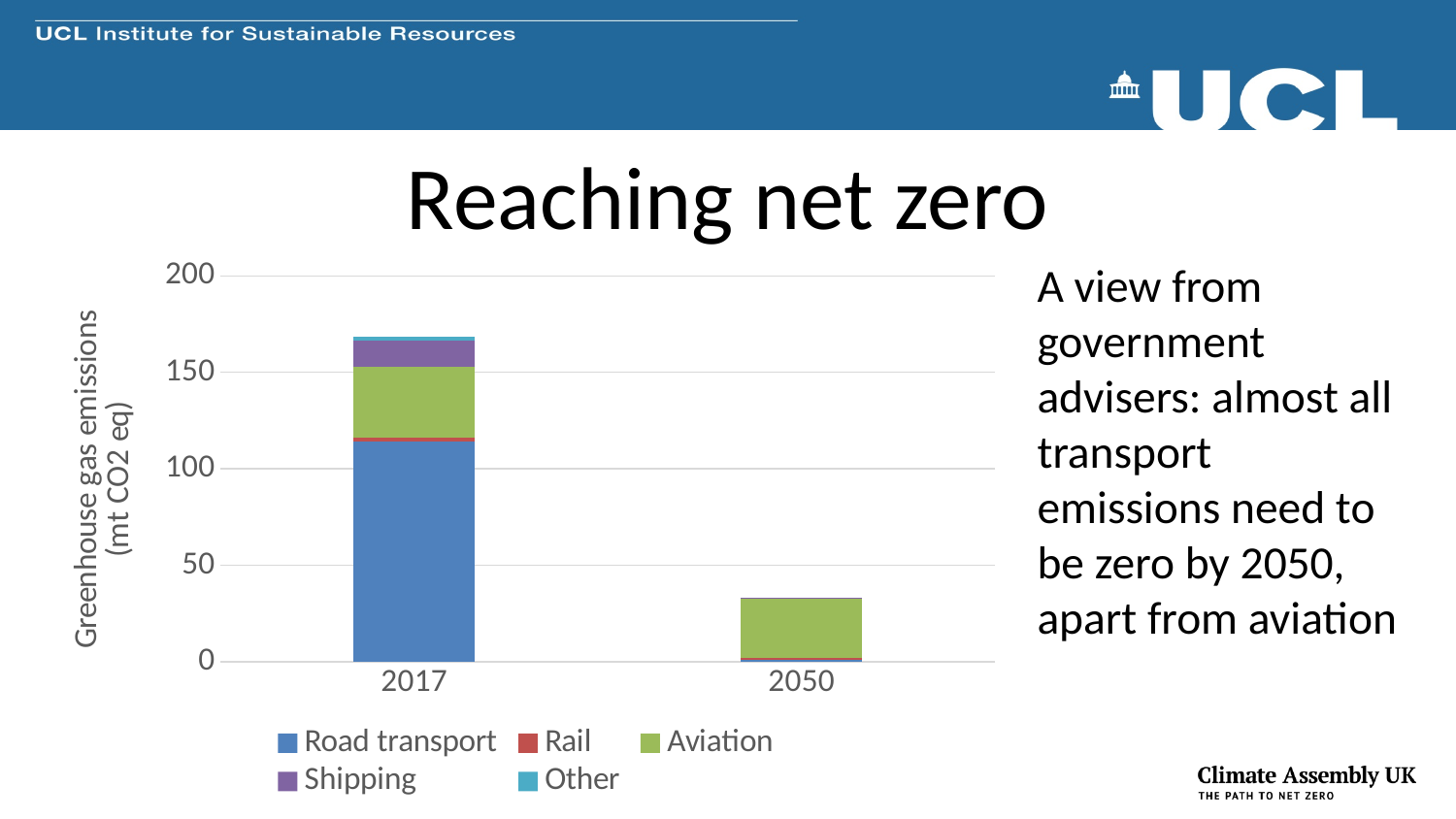
Is the Road transport value for 2017 greater or less than 100? greater How many categories are shown on the x axis of the chart? 2 Which year has the lowest total greenhouse gas emissions in the chart? 2050 How many series does the chart's legend list? 5 Is the total greenhouse gas emissions value for 2017 greater or less than 150? greater Which series makes up almost all of the 2050 bar? Aviation Is the total greenhouse gas emissions value for 2050 greater or less than 50? less What is the label on the vertical axis of the chart? Greenhouse gas emissions (mt CO2 eq) What kind of chart is shown on the slide? Stacked bar chart Which series are listed in the chart's legend? Road transport, Rail, Aviation, Shipping, Other Do total greenhouse gas emissions rise or fall from 2017 to 2050 in the chart? Fall Which year has the higher total greenhouse gas emissions, 2017 or 2050? 2017